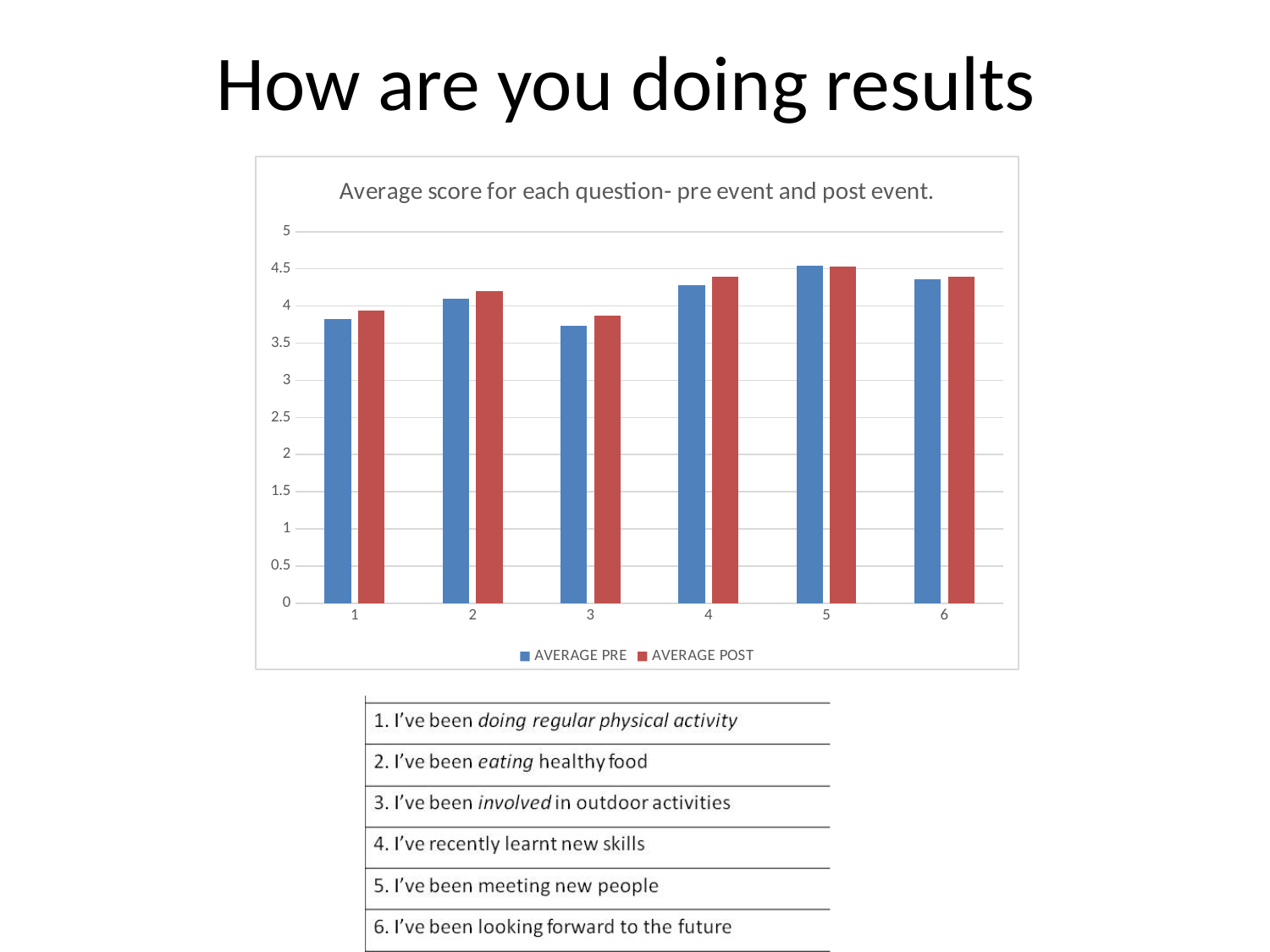
Is the AVERAGE PRE value for question 1 greater or less than 4? less Which question has the highest AVERAGE POST score? 5 Which is larger, the AVERAGE PRE value for question 3 or for question 4? question 4 What is the title of the chart? Average score for each question- pre event and post event. How many question categories are plotted along the x axis? 6 What kind of chart is shown on the slide? bar chart Is the AVERAGE POST value for question 2 greater or less than 4? greater Which question has the highest AVERAGE PRE score? 5 Which question has the lowest AVERAGE PRE score? 3 Which series is shown in red? AVERAGE POST How many series does the legend list? 2